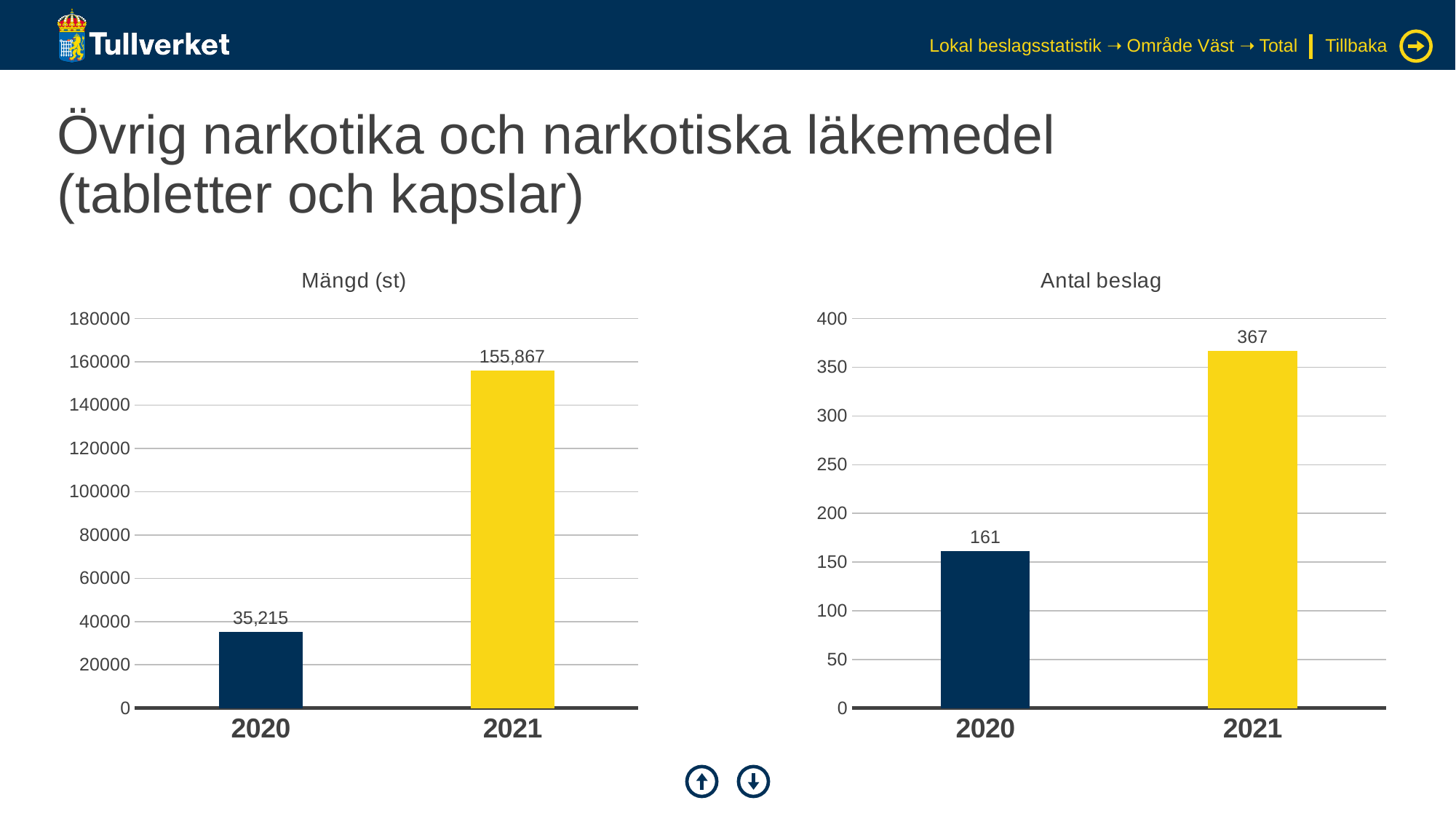
In the 'Antal beslag' chart, which year has the highest value? 2021 In the 'Mängd (st)' chart, which year has the lowest value? 2020 What kind of chart is the 'Antal beslag' chart? bar chart In the 'Mängd (st)' chart, what is the difference between the 2021 and 2020 values? 120,652 In the 'Antal beslag' chart, what is the value for 2020? 161 In the 'Mängd (st)' chart, is the value for 2020 greater or less than 40000? less In the 'Antal beslag' chart, what is the value for 2021? 367 In the 'Mängd (st)' chart, what is the value for 2021? 155,867 In the 'Mängd (st)' chart, do the values rise or fall from 2020 to 2021? rise In the 'Antal beslag' chart, what is the difference between the 2021 and 2020 values? 206 In the 'Antal beslag' chart, how many years are shown on the x axis? 2 In the 'Mängd (st)' chart, what is the value for 2020? 35,215